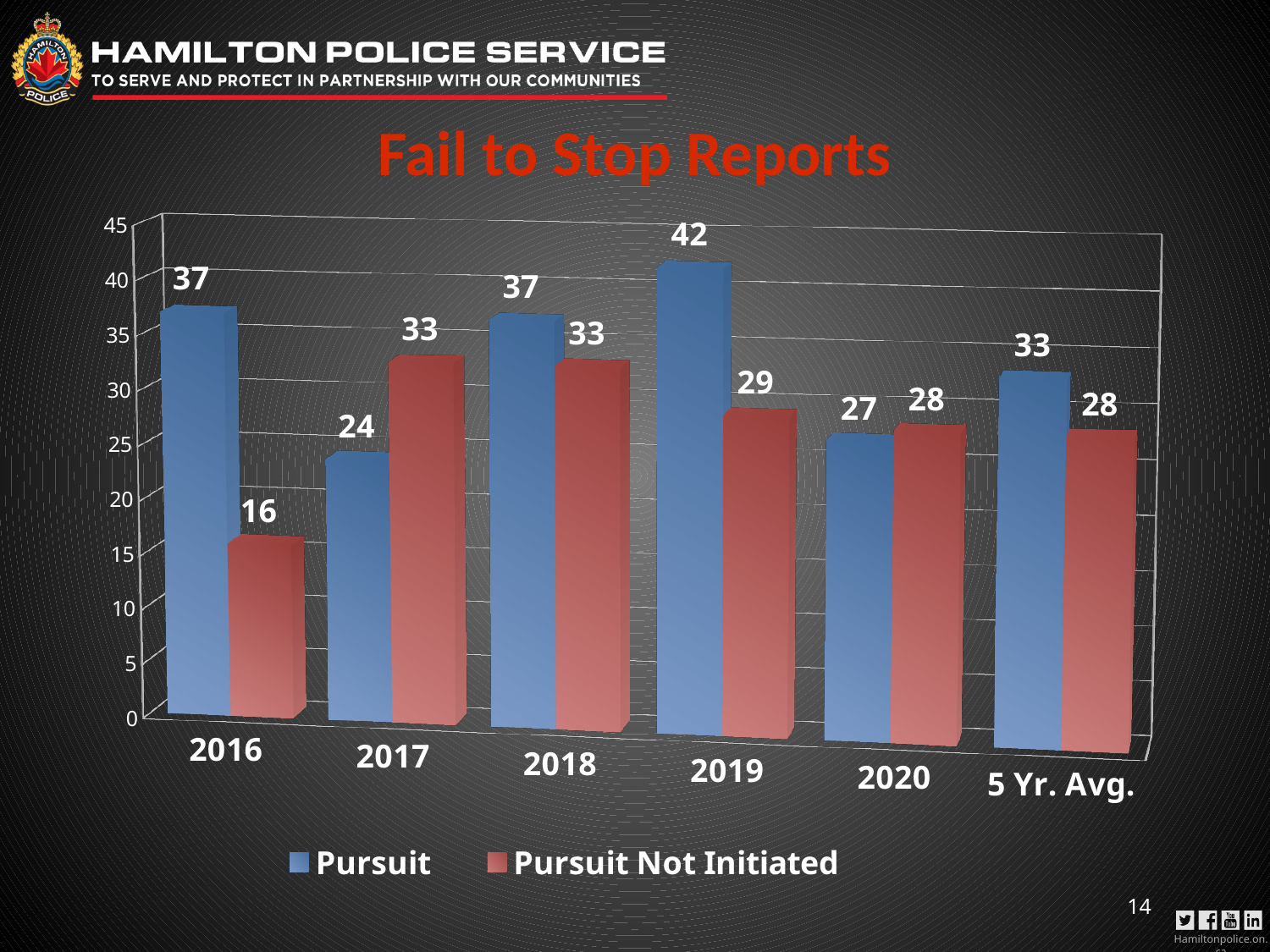
What is the Pursuit value for 2019? 42 What is the title of the chart? Fail to Stop Reports How many categories are shown on the x axis? 6 Which is larger in 2017, Pursuit or Pursuit Not Initiated? Pursuit Not Initiated What is the Pursuit Not Initiated value for 2016? 16 What colour are the Pursuit Not Initiated bars? red Which category has the highest Pursuit value? 2019 Which category has the lowest Pursuit Not Initiated value? 2016 What kind of chart is shown on the slide? bar chart How many series does the legend list? 2 What is the Pursuit value for the 5 Yr. Avg. category? 33 What is the difference between the Pursuit and Pursuit Not Initiated values in 2016? 21